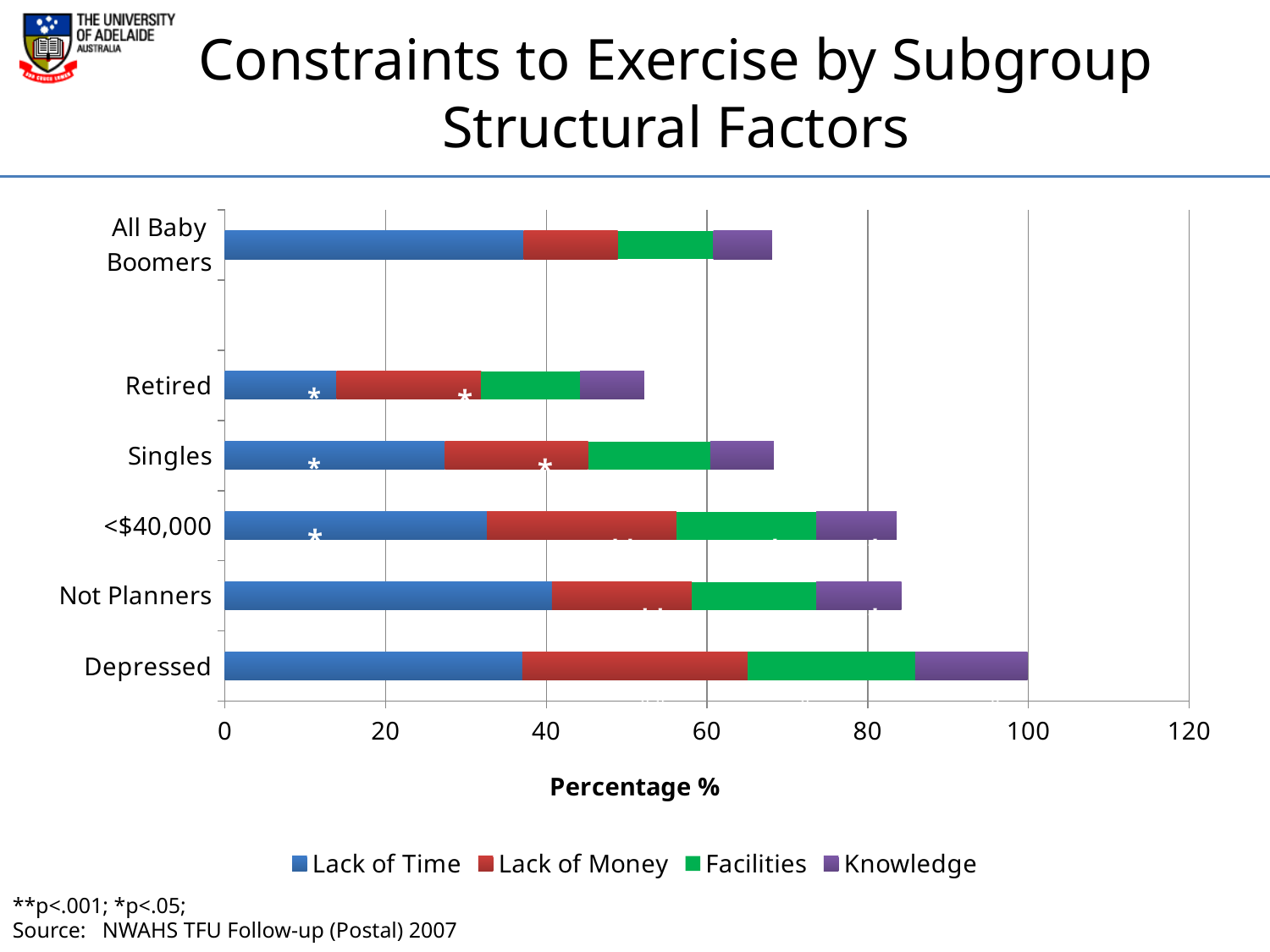
What is the title of the horizontal axis? Percentage % Which subgroup has the shortest total stacked bar? Retired Is the total stacked bar for Retired greater or less than 60? less Which subgroup has the smallest Lack of Time segment? Retired Is the Lack of Time value for Retired greater or less than 20? less Is the total stacked bar for Depressed greater or less than 80? greater Which has the longer total stacked bar, Singles or Retired? Singles What kind of chart is shown on the slide? Stacked bar chart How many series does the legend list? 4 Which subgroup has the longest total stacked bar? Depressed How many subgroups are plotted on the chart? 6 Which has the longer total stacked bar, Depressed or Not Planners? Depressed